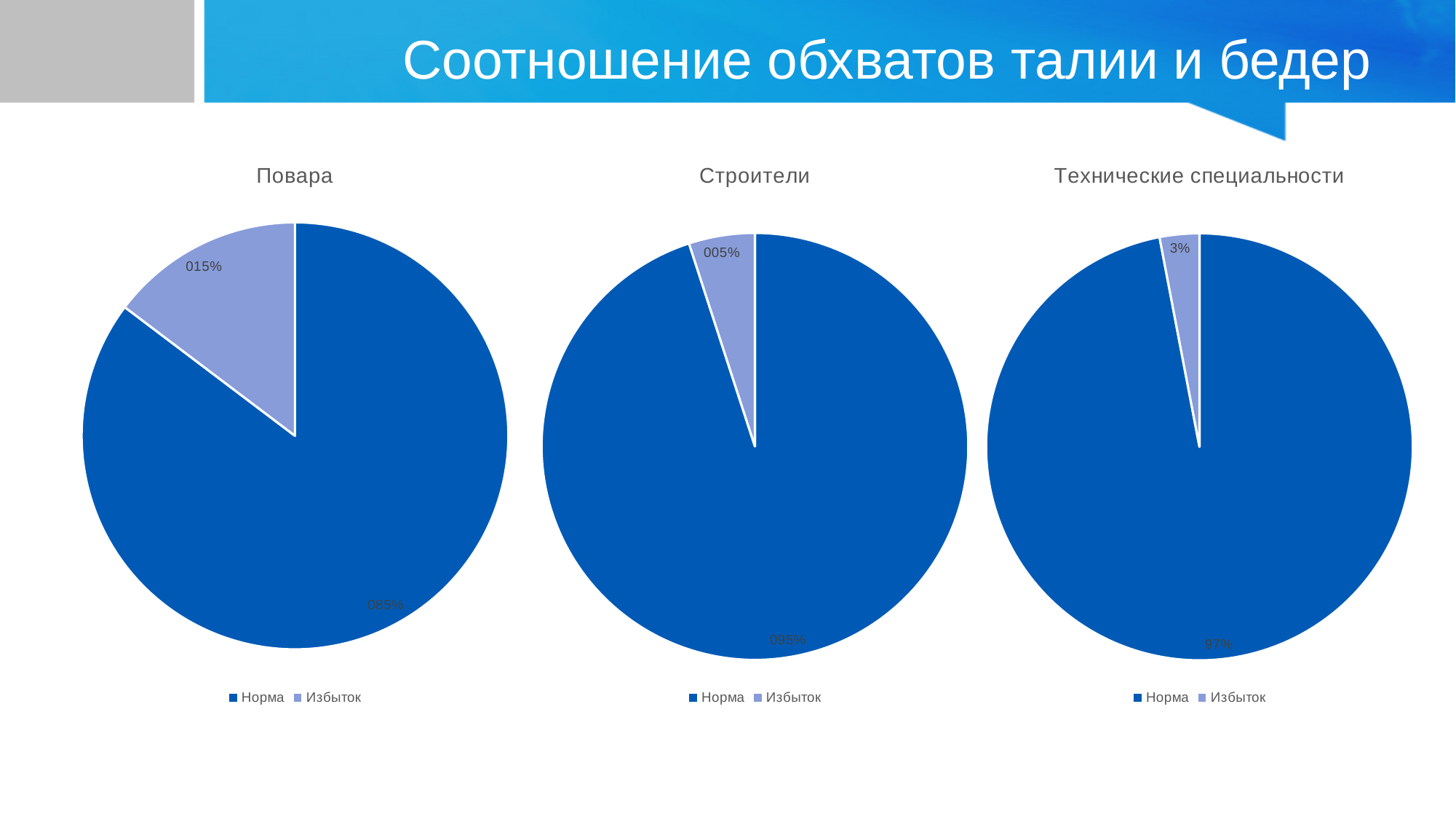
In the 'Строители' chart, what is the value shown for Избыток? 005% What is the title of the slide? Соотношение обхватов талии и бедер In the 'Строители' chart, which category has the smallest slice? Избыток Which is larger: the Избыток slice in the 'Повара' chart or the Избыток slice in the 'Технические специальности' chart? Повара In the 'Повара' chart, what is the value shown for Избыток? 015% How many categories does the legend of the 'Повара' chart list? 2 In the 'Строители' chart, what is the value shown for Норма? 095% In the 'Повара' chart, which category has the largest slice? Норма In the 'Технические специальности' chart, what is the value shown for Избыток? 3% What type of chart is used for 'Технические специальности'? Pie chart In the 'Повара' chart, what is the value shown for Норма? 085% In the 'Технические специальности' chart, what is the value shown for Норма? 97%